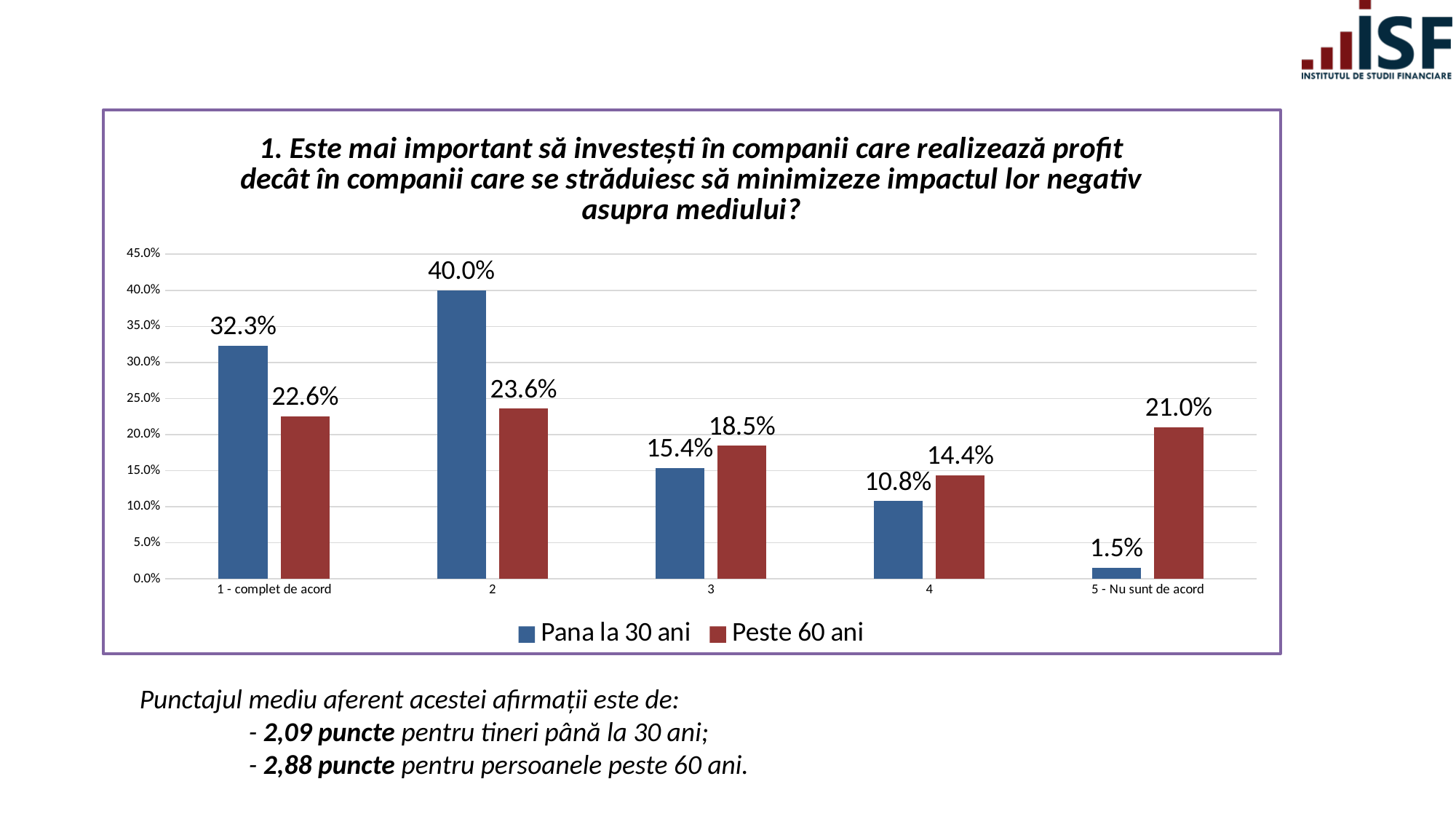
Which series is shown in blue in the legend? Pana la 30 ani What is the value for "Pana la 30 ani" in category "1 - complet de acord"? 32.3% What type of chart is shown on the slide? bar chart In category 3, which series has the larger value, "Pana la 30 ani" or "Peste 60 ani"? Peste 60 ani What is the difference between "Pana la 30 ani" and "Peste 60 ani" in category 2? 16.4% What is the value for "Pana la 30 ani" in category 2? 40.0% Which category has the lowest value for "Peste 60 ani"? 4 What is the value for "Peste 60 ani" in category "5 - Nu sunt de acord"? 21.0% Which category has the highest value for "Pana la 30 ani"? 2 How many categories are shown on the x axis? 5 How many series does the legend list? 2 Which category has the lowest value for "Pana la 30 ani"? 5 - Nu sunt de acord